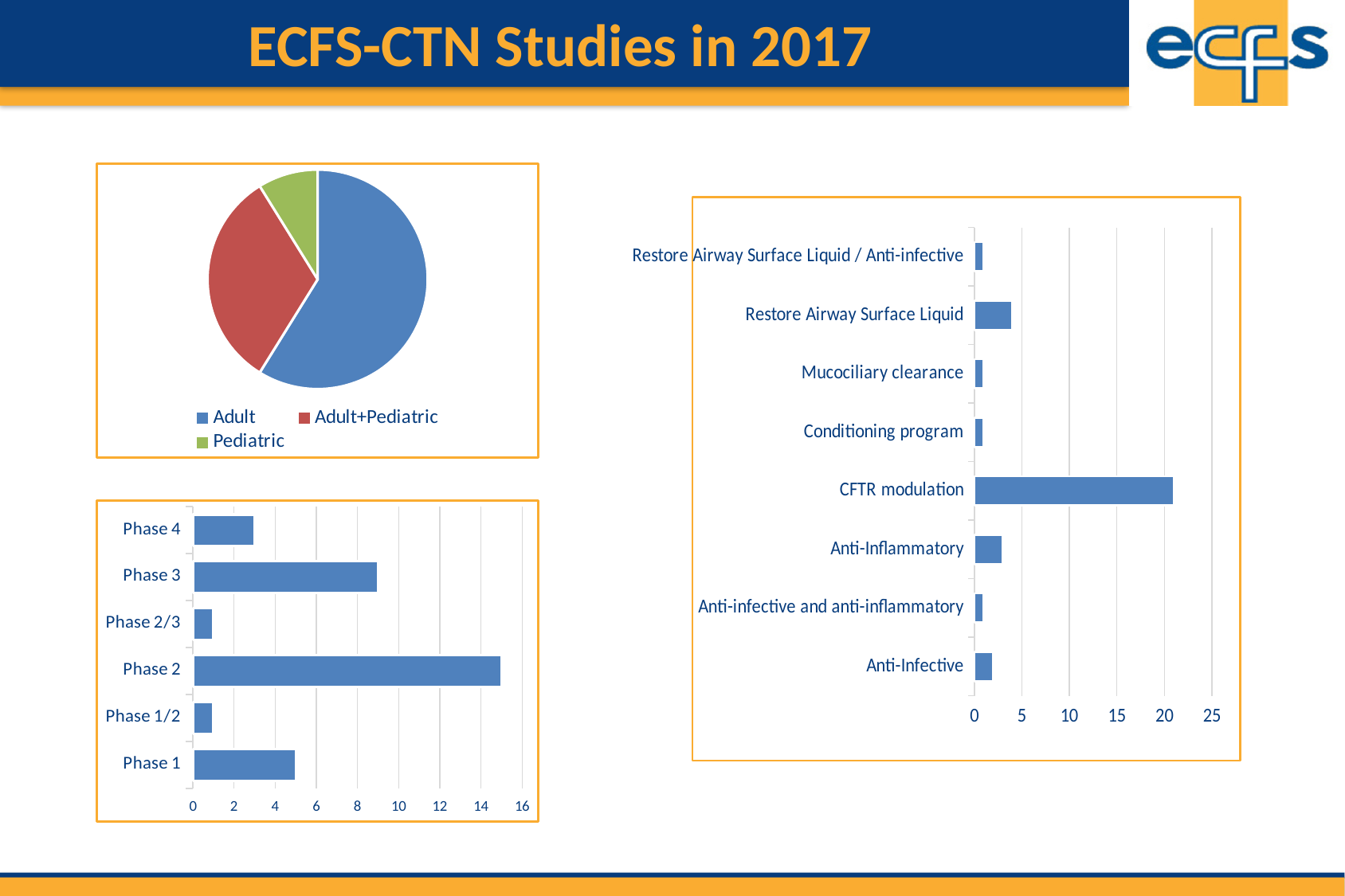
How many categories are shown in the bar chart on the right? 8 What kind of chart is the chart at the top left of the slide? Pie chart How many phases are shown in the bar chart at the bottom left? 6 In the bar chart at the bottom left, which has the larger value, Phase 4 or Phase 1? Phase 1 In the bar chart on the right, is the value for CFTR modulation greater or less than 20? greater In the bar chart at the bottom left, is the value for Phase 2 greater or less than 14? greater In the pie chart at the top left, which category has the largest slice? Adult In the bar chart at the bottom left, is the value for Phase 3 greater or less than 8? greater In the bar chart at the bottom left, which phase has the highest value? Phase 2 How many categories does the legend of the pie chart at the top left list? 3 In the pie chart at the top left, which category has the smallest slice? Pediatric In the bar chart on the right, which category has the highest value? CFTR modulation